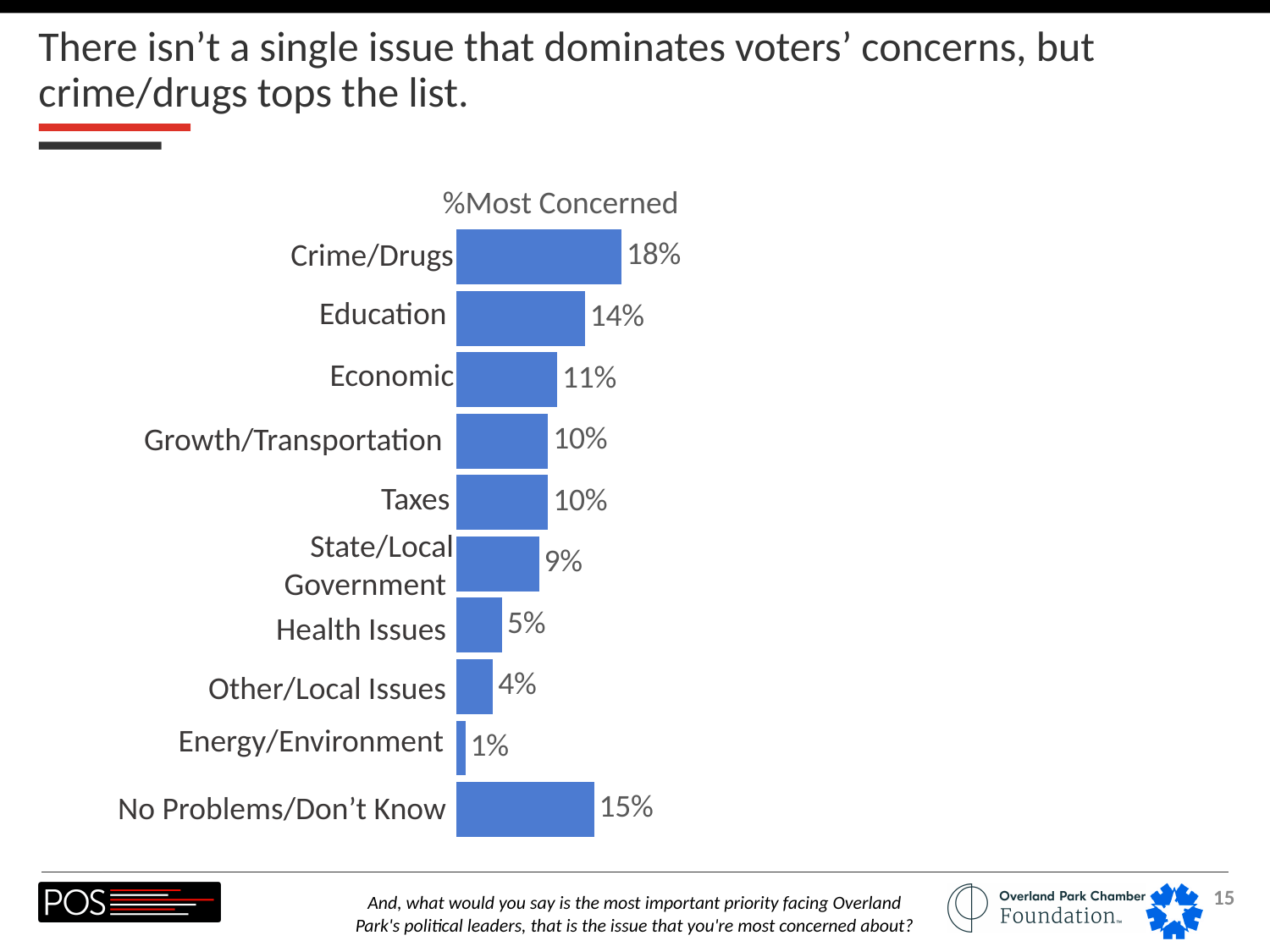
How many categories are shown in the chart? 10 What is the value for State/Local Government? 9% What is the value for Education? 14% Which category has the lowest value? Energy/Environment Which category has the highest value? Crime/Drugs What kind of chart is shown on the slide? Bar chart What is the difference between the values for Economic and Health Issues? 6% What is the difference between the values for Crime/Drugs and Education? 4% What is the title of the chart? %Most Concerned What is the value for Crime/Drugs? 18% What is the value for No Problems/Don't Know? 15% Which is larger, the value for Taxes or the value for Other/Local Issues? Taxes